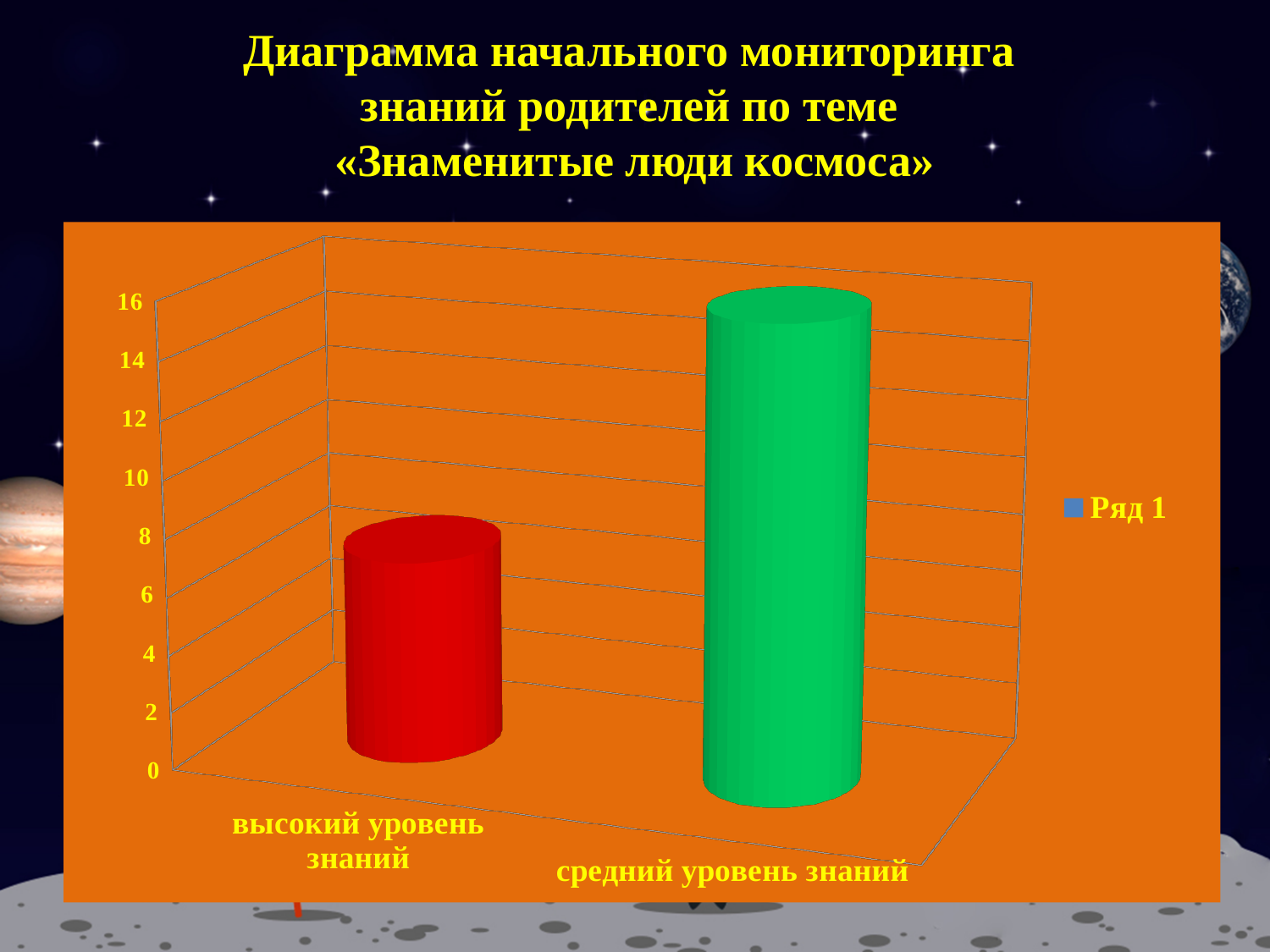
Is the value for высокий уровень знаний greater or less than 2? greater Which category has the highest value? средний уровень знаний Which category has the lowest value? высокий уровень знаний What is the name of the series in the legend? Ряд 1 How many series does the legend list? 1 How many categories are shown on the chart? 2 Is the value for высокий уровень знаний greater or less than 10? less Which is larger: the value for высокий уровень знаний or the value for средний уровень знаний? средний уровень знаний What is the maximum value shown on the vertical axis? 16 What kind of chart is shown on the slide? bar chart Is the value for средний уровень знаний greater or less than 10? greater Do the values rise or fall from the first category to the second along the x axis? rise